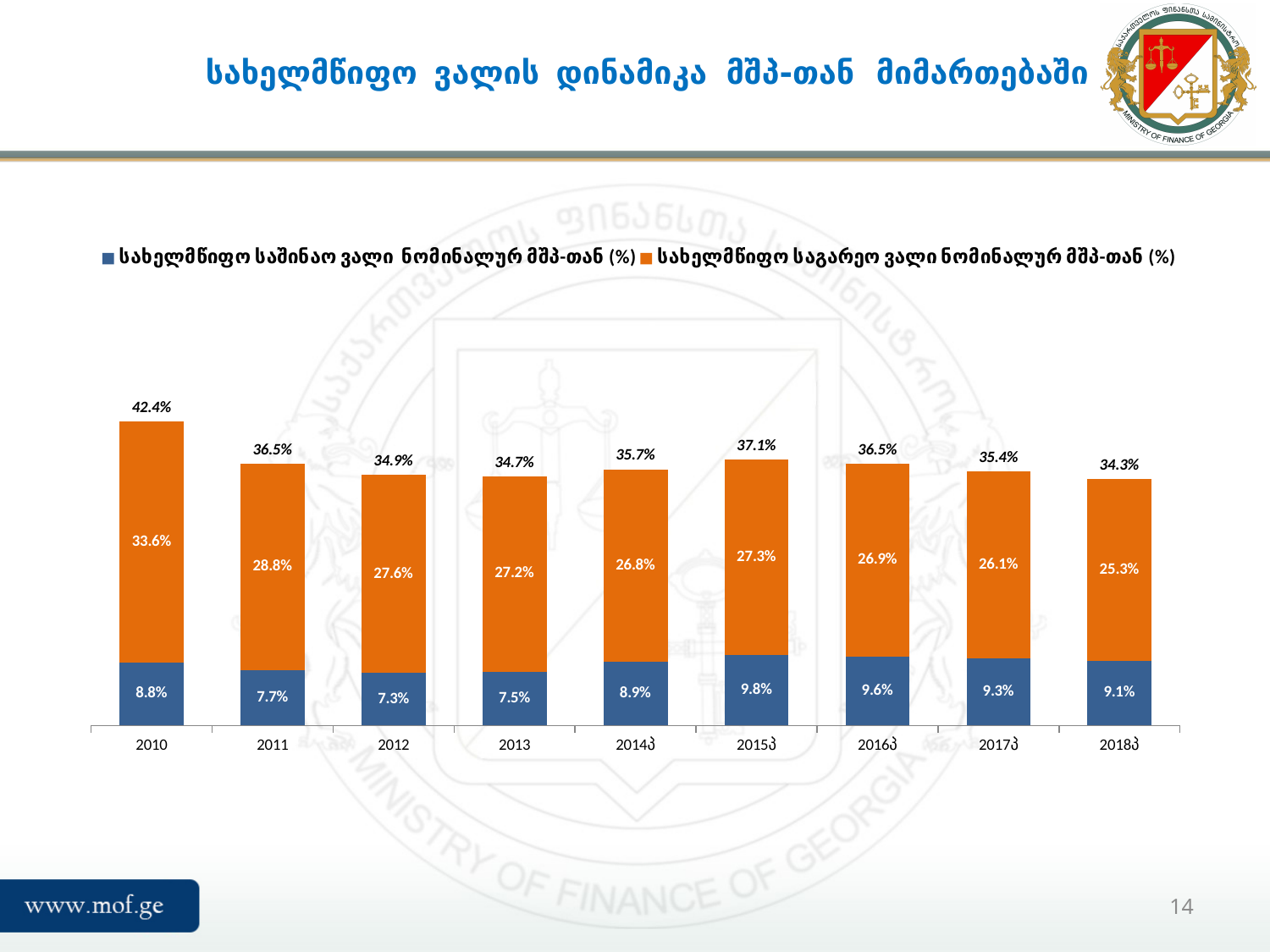
In which year is the total stacked bar the highest? 2010 What kind of chart is shown on the slide? bar chart What is the value of the blue series (სახელმწიფო საშინაო ვალი ნომინალურ მშპ-თან) for 2010? 8.8% What is the value of the orange series (სახელმწიფო საგარეო ვალი ნომინალურ მშპ-თან) for 2013? 27.2% Which colour represents სახელმწიფო საგარეო ვალი ნომინალურ მშპ-თან (%) in the legend? orange In which year is the blue series (domestic debt) value the lowest? 2012 Does the orange series value generally rise or fall from 2010 to 2018პ? fall Which is larger, the blue series value for 2015პ or for 2018პ? 2015პ What is the total shown above the stacked bar for 2015პ? 37.1% How many years are shown on the x axis? 9 How many series does the legend list? 2 What is the difference between the orange series values for 2010 and 2018პ? 8.3%